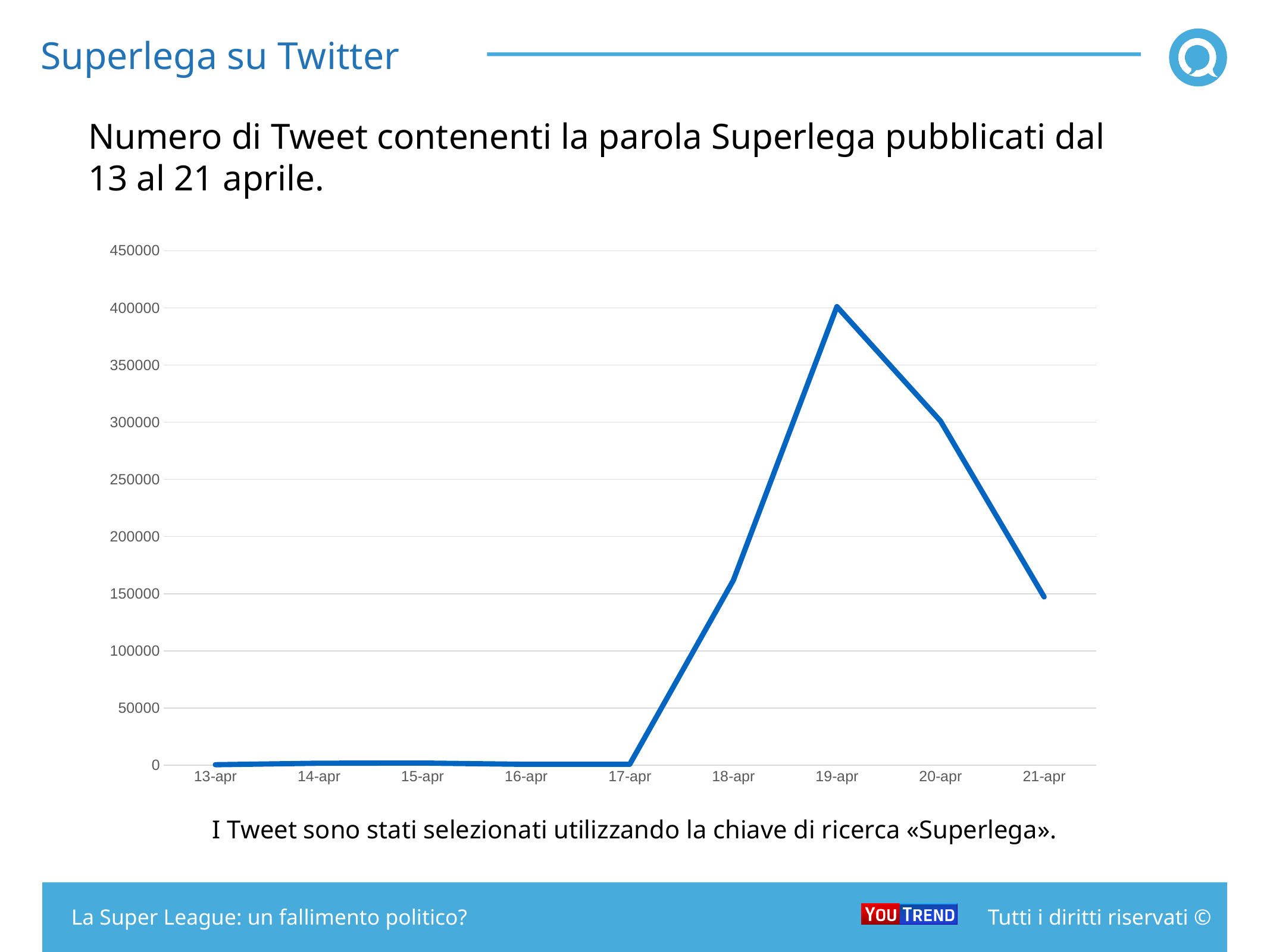
Is the value for 19-apr greater or less than 350000? greater Which date has the larger value, 18-apr or 20-apr? 20-apr Is the value for 20-apr greater or less than 250000? greater On which date is the number of tweets highest? 19-apr Is the value for 18-apr greater or less than 100000? greater How many dates are plotted along the x axis? 9 What is the highest value shown on the y axis? 450000 Do the values rise or fall from 19-apr to 21-apr? fall Which date has the larger value, 20-apr or 21-apr? 20-apr What kind of chart is shown on the slide? line chart